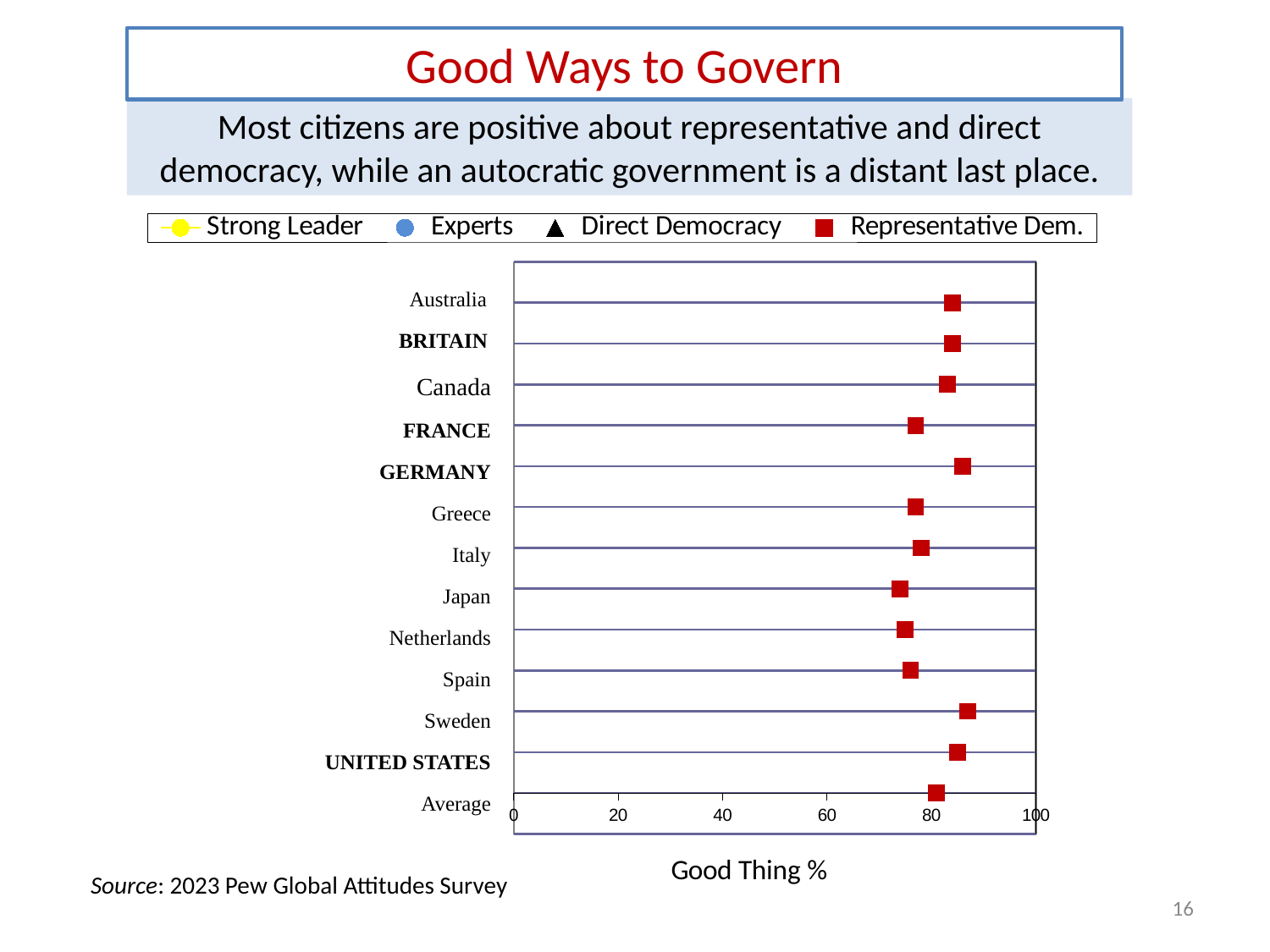
Is the Representative Dem. value for Germany greater or less than 80? greater Is the Representative Dem. value for Netherlands greater or less than 80? less Which has the larger Representative Dem. value, Germany or France? Germany Is the Representative Dem. value for Japan greater or less than 80? less What is the label on the horizontal axis of the chart? Good Thing % How many countries/categories are plotted on the chart (including Average)? 13 How many series does the chart legend list? 4 What kind of chart is shown on the slide? scatter chart Which has the larger Representative Dem. value, Sweden or Japan? Sweden Which legend entry is shown with a red square marker? Representative Dem.